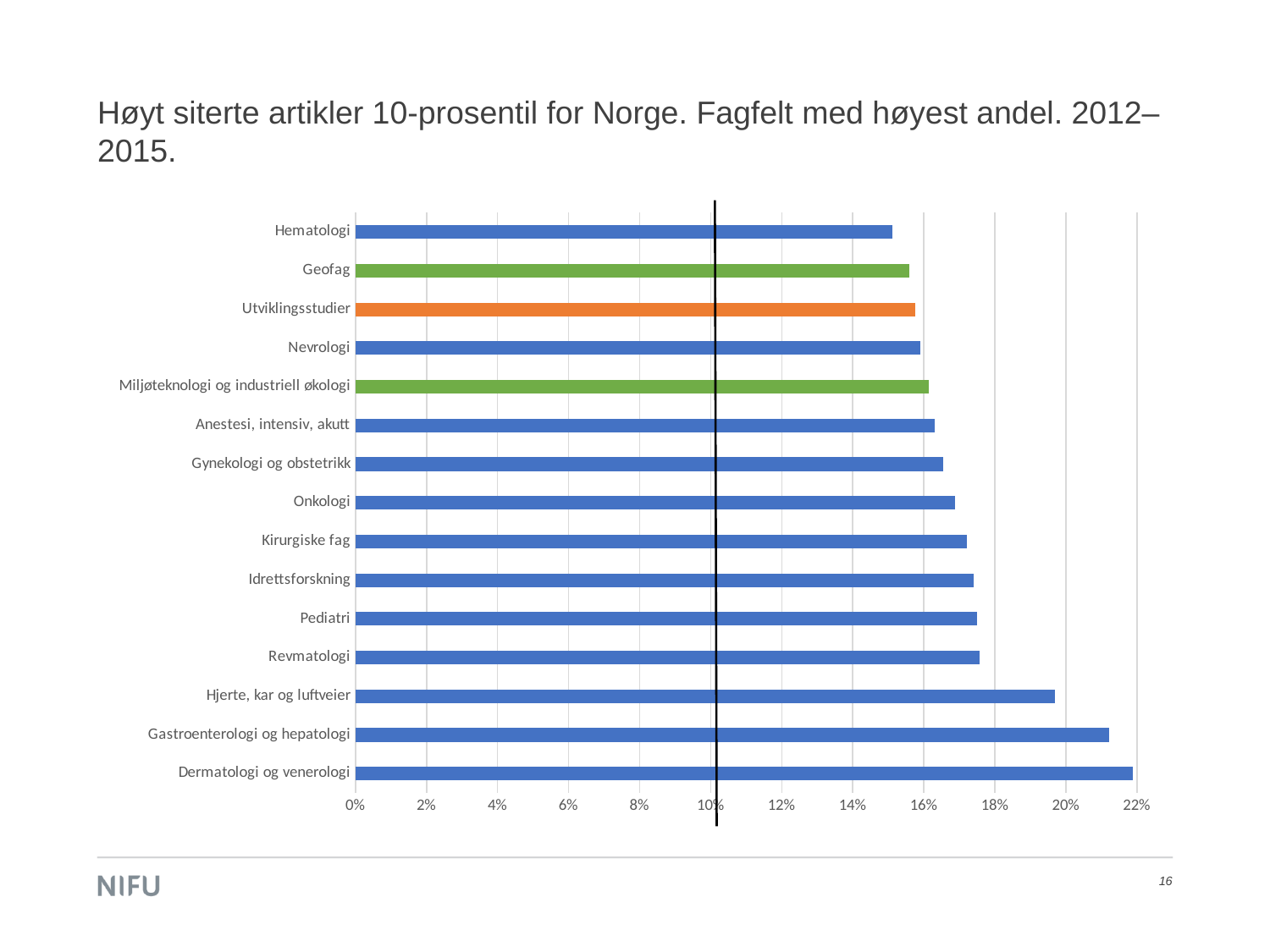
Which field has the highest share of highly cited articles? Dermatologi og venerologi What kind of chart is shown on the slide? Bar chart Which has the larger value: Gastroenterologi og hepatologi or Hjerte, kar og luftveier? Gastroenterologi og hepatologi Do the bar values increase or decrease going from the top category (Hematologi) to the bottom category (Dermatologi og venerologi)? increase Is the value for Revmatologi greater or less than 18%? less Is the value for Hematologi greater or less than 16%? less Is the value for Hjerte, kar og luftveier greater or less than 18%? greater Which has the larger value: Onkologi or Hematologi? Onkologi Which field has the lowest share of highly cited articles? Hematologi Which field's bar is coloured orange? Utviklingsstudier How many fields (categories) are plotted in the chart? 15